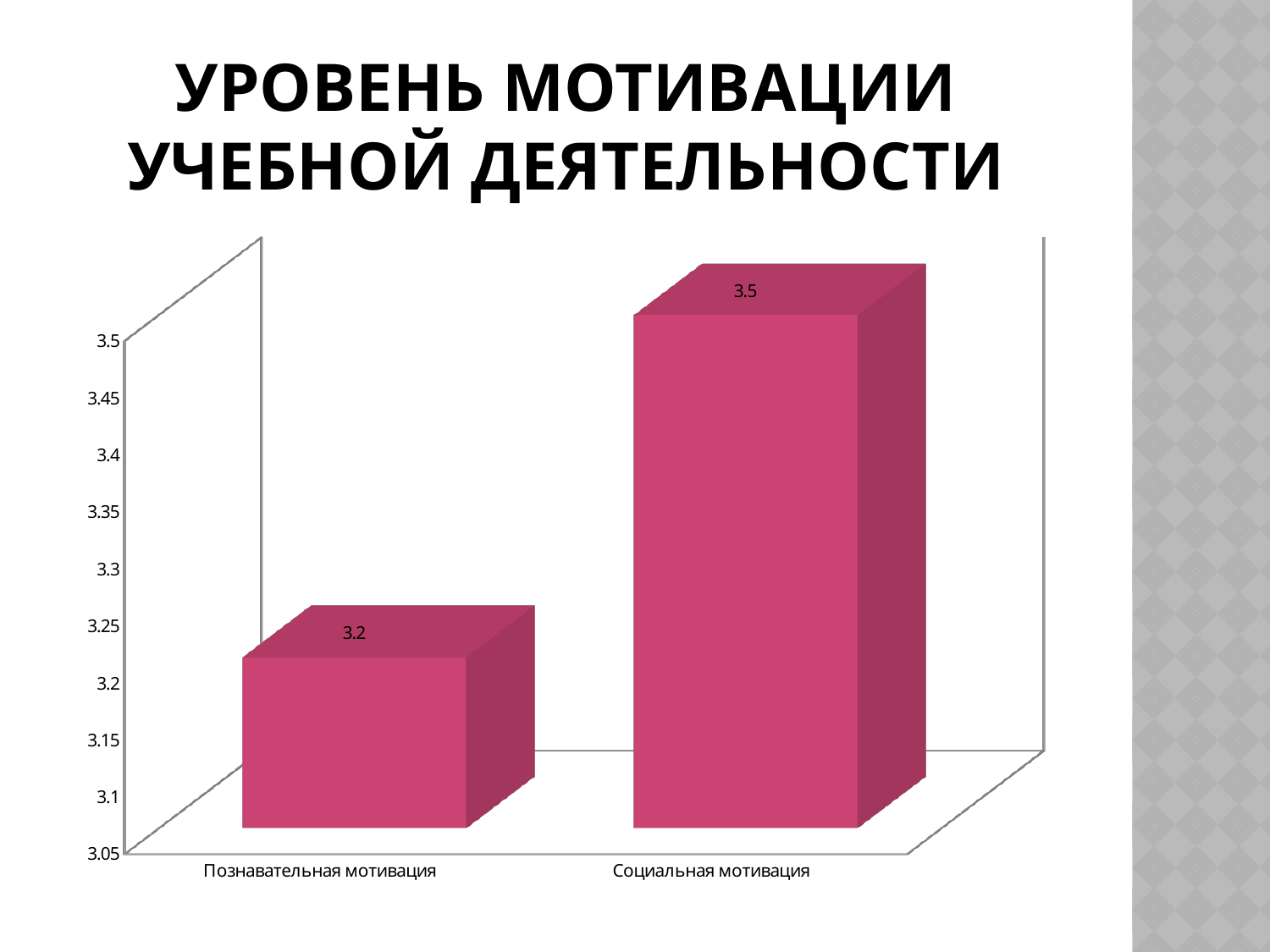
What is the value for Познавательная мотивация? 3.2 How many categories are shown on the chart? 2 Is the value for Познавательная мотивация greater or less than 3.3? less Which category has the highest value? Социальная мотивация Which is larger, the value for Познавательная мотивация or the value for Социальная мотивация? Социальная мотивация Which category has the lowest value? Познавательная мотивация Is the value for Социальная мотивация greater or less than 3.4? greater What is the lowest value shown on the vertical axis? 3.05 What is the title of the slide? УРОВЕНЬ МОТИВАЦИИ УЧЕБНОЙ ДЕЯТЕЛЬНОСТИ What is the value for Социальная мотивация? 3.5 What is the difference between the values for Социальная мотивация and Познавательная мотивация? 0.3 What kind of chart is shown on the slide? bar chart